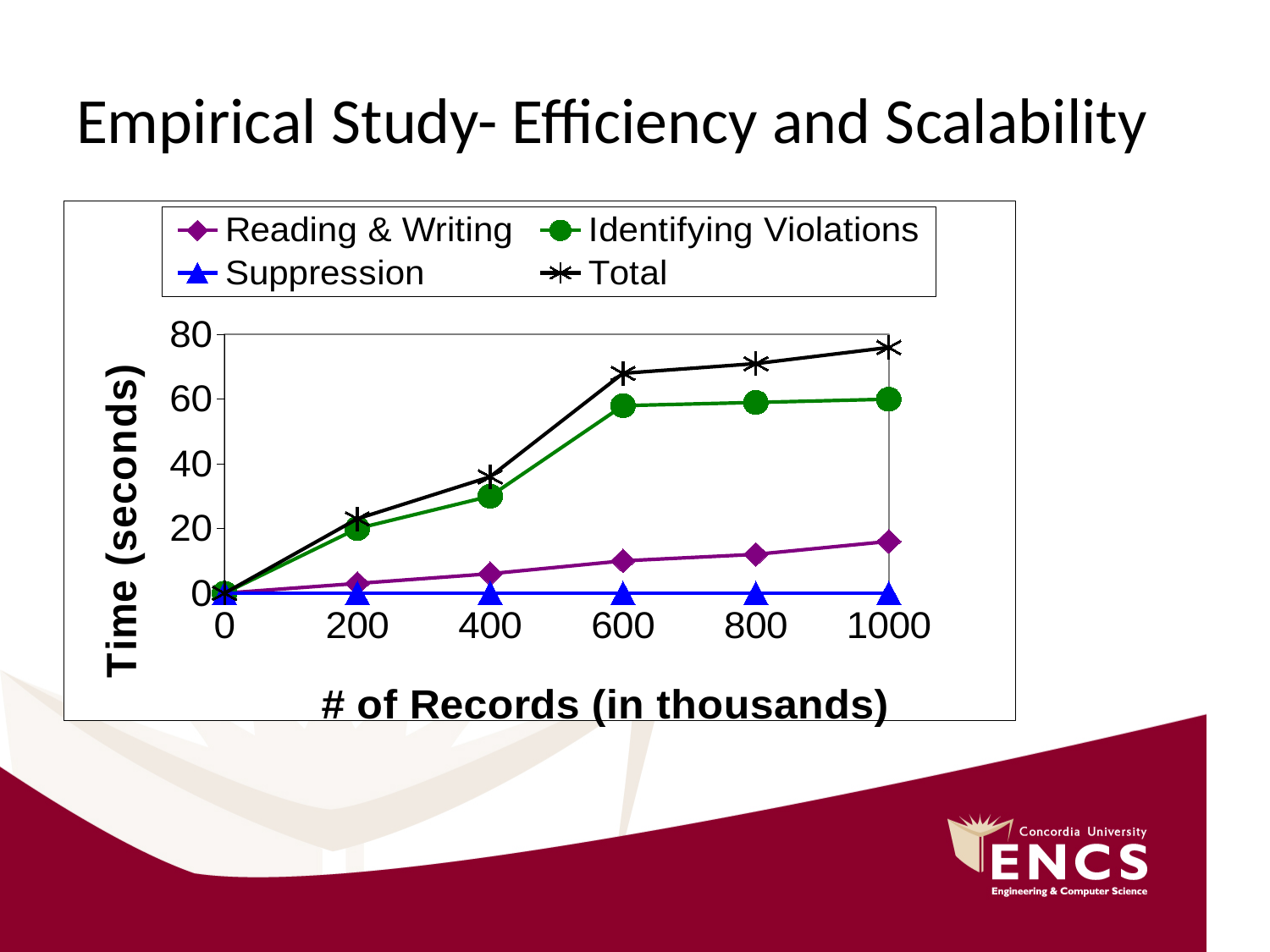
What is the label of the y axis? Time (seconds) Which series has the highest value at 1000 thousand records? Total Is the value for Reading & Writing at 1000 thousand records greater or less than 20? less How many series does the legend list? 4 At 800 thousand records, which is larger: Reading & Writing or Suppression? Reading & Writing Is the value for Total at 1000 thousand records greater or less than 60? greater Does the Total series rise or fall as the number of records increases? rise What kind of chart is shown on the slide? line chart Which series has the lowest values across the chart? Suppression How many x-axis points (record counts) are plotted for each series? 6 Is the value for Total at 600 thousand records greater or less than 60? greater